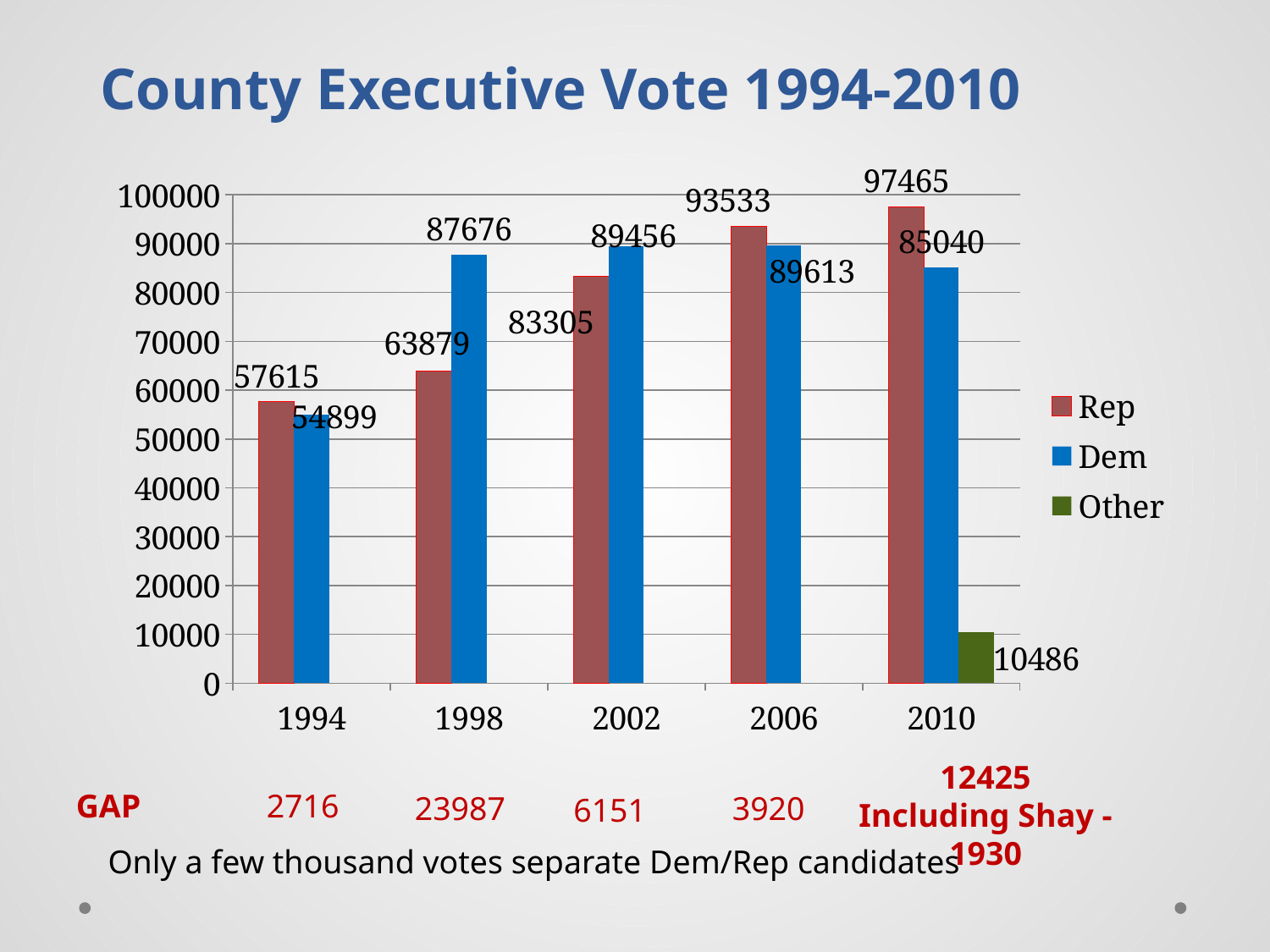
Is the Rep value for 1994 greater or less than 60000? less Do the Rep values rise or fall from 1994 to 2010? rise What is the difference between the Rep and Dem values in 2002? 6151 How many series does the legend list? 3 What is the Other value for 2010? 10486 In which year is the Rep value highest? 2010 What is the difference between the Rep and Dem values in 2010? 12425 What is the Dem value for 1998? 87676 In which year is the Dem value lowest? 1994 Which is larger in 1998, the Rep value or the Dem value? Dem What is the Rep value for 2010? 97465 How many years are shown on the x axis? 5